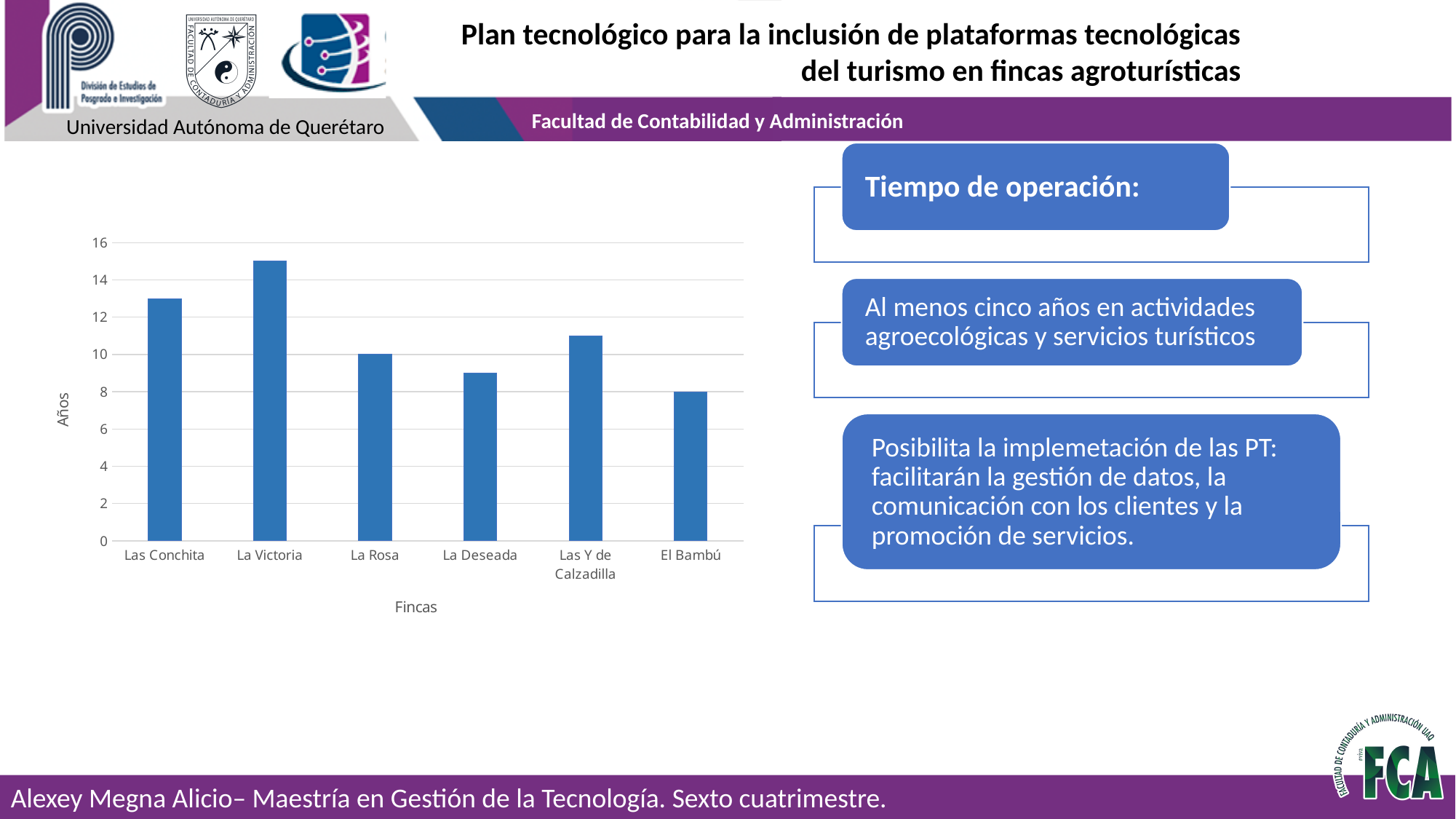
Which finca has the lowest value in the chart? El Bambú What is the value (Años) for El Bambú? 8 Is the value for Las Conchita greater or less than 12? greater What kind of chart is shown on the slide? bar chart What is the difference between the values for La Rosa and El Bambú? 2 What is the value (Años) for La Rosa? 10 Is the value for La Deseada greater or less than 10? less What is the label of the vertical axis of the chart? Años Is the value for La Victoria greater or less than 14? greater How many fincas are shown on the x axis of the chart? 6 Which finca has the highest value in the chart? La Victoria Which has a larger value, Las Conchita or Las Y de Calzadilla? Las Conchita